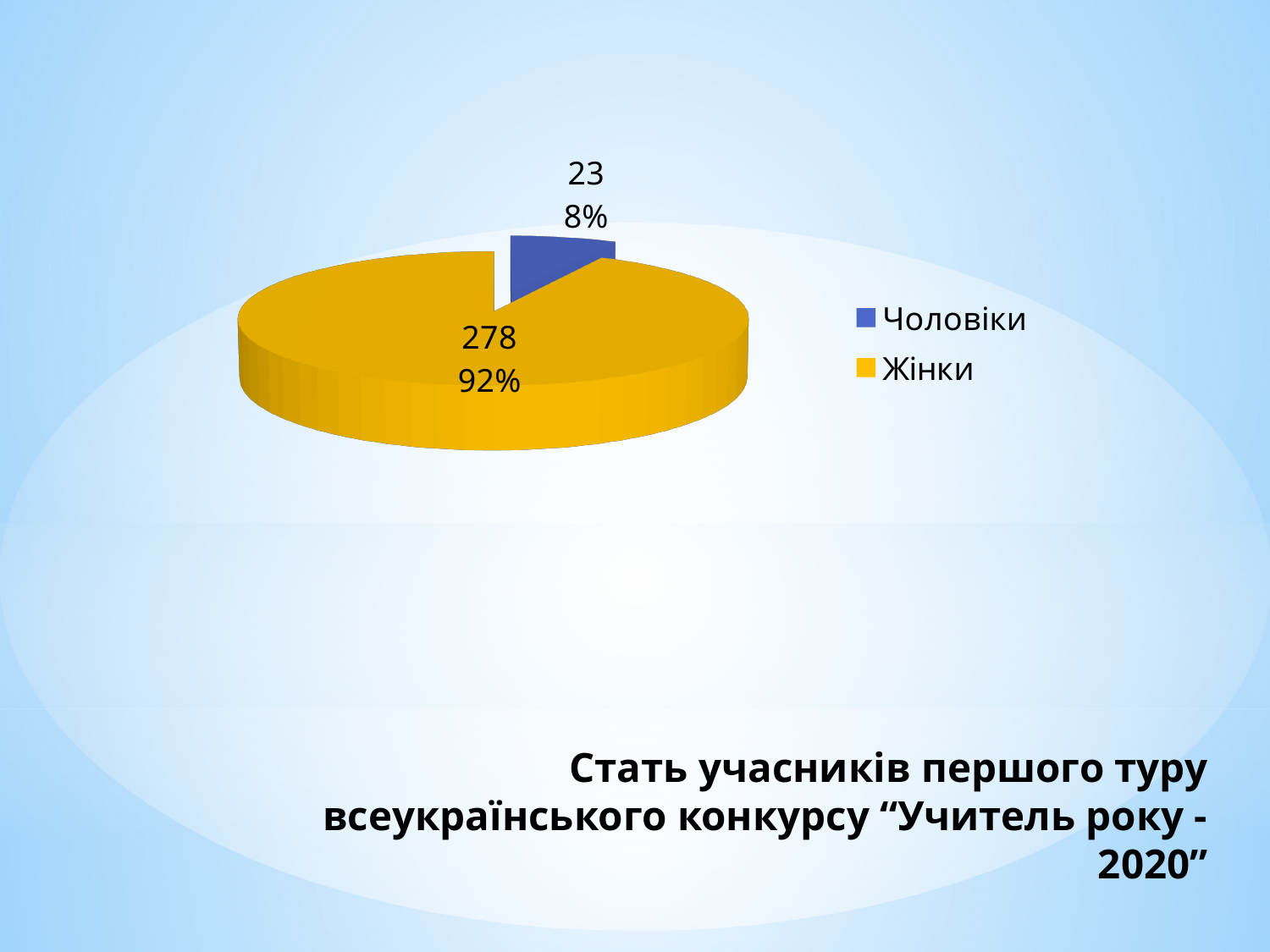
What is the value for Жінки? 278 Which category has the smallest slice? Чоловіки What share of the pie does Жінки represent? 92% How many slices does the pie chart have? 2 What colour is the slice for Жінки? yellow What is the difference between the values for Жінки and Чоловіки? 255 How many entries does the legend list? 2 What share of the pie does Чоловіки represent? 8% Which category has the largest slice? Жінки What is the value for Чоловіки? 23 What kind of chart is shown on the slide? pie chart Which is larger, the value for Чоловіки or the value for Жінки? Жінки